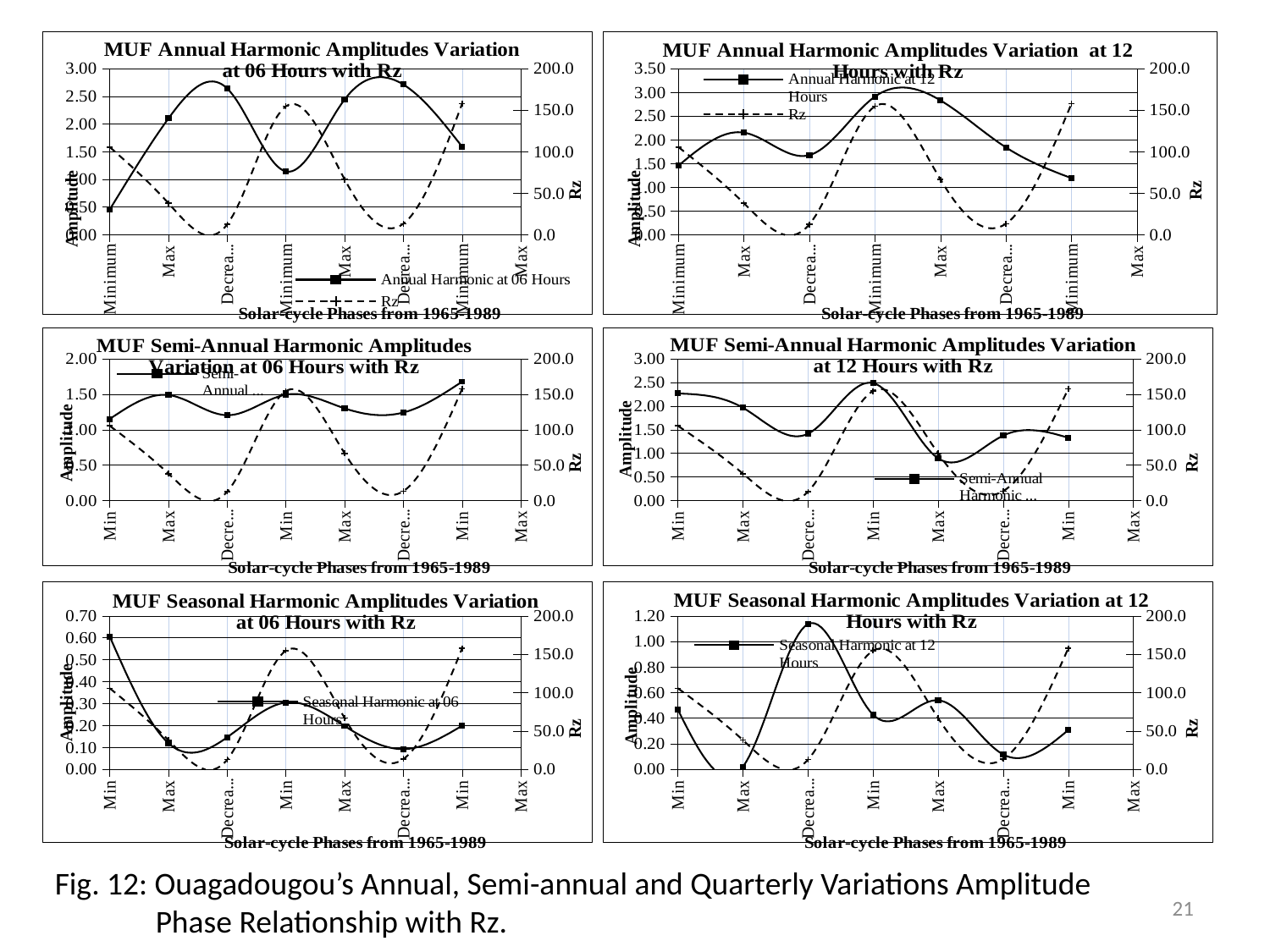
What is the x-axis title of the middle-left chart (Semi-Annual Harmonic at 06 Hours)? Solar-cycle Phases from 1965-1989 In the top-left chart (Annual Harmonic at 06 Hours), does the Annual Harmonic line rise or fall from the first 'Minimum' to the first 'Max' category? rise How many charts are shown on the slide? 6 In the top-left chart (Annual Harmonic at 06 Hours), how many series does the legend list? 2 In the bottom-left chart (Seasonal Harmonic at 06 Hours), at which category is the Seasonal Harmonic value highest? Min (the first category) In the bottom-right chart (Seasonal Harmonic at 12 Hours), is the Seasonal Harmonic value at the first 'Max' category greater or less than 0.20? less What is the highest tick value on the right-hand (Rz) axis of the top-right chart (Annual Harmonic at 12 Hours)? 200.0 In the bottom-left chart (Seasonal Harmonic at 06 Hours), is the Seasonal Harmonic value at the first 'Min' category greater or less than 0.50? greater In the top-left chart (Annual Harmonic at 06 Hours), is the Annual Harmonic value at the first 'Minimum' category greater or less than 1.00? less What kind of chart is the top-left chart, 'MUF Annual Harmonic Amplitudes Variation at 06 Hours with Rz'? Line chart In the top-left chart (Annual Harmonic at 06 Hours), does the Rz line rise or fall from the first 'Minimum' to the first 'Max' category? fall